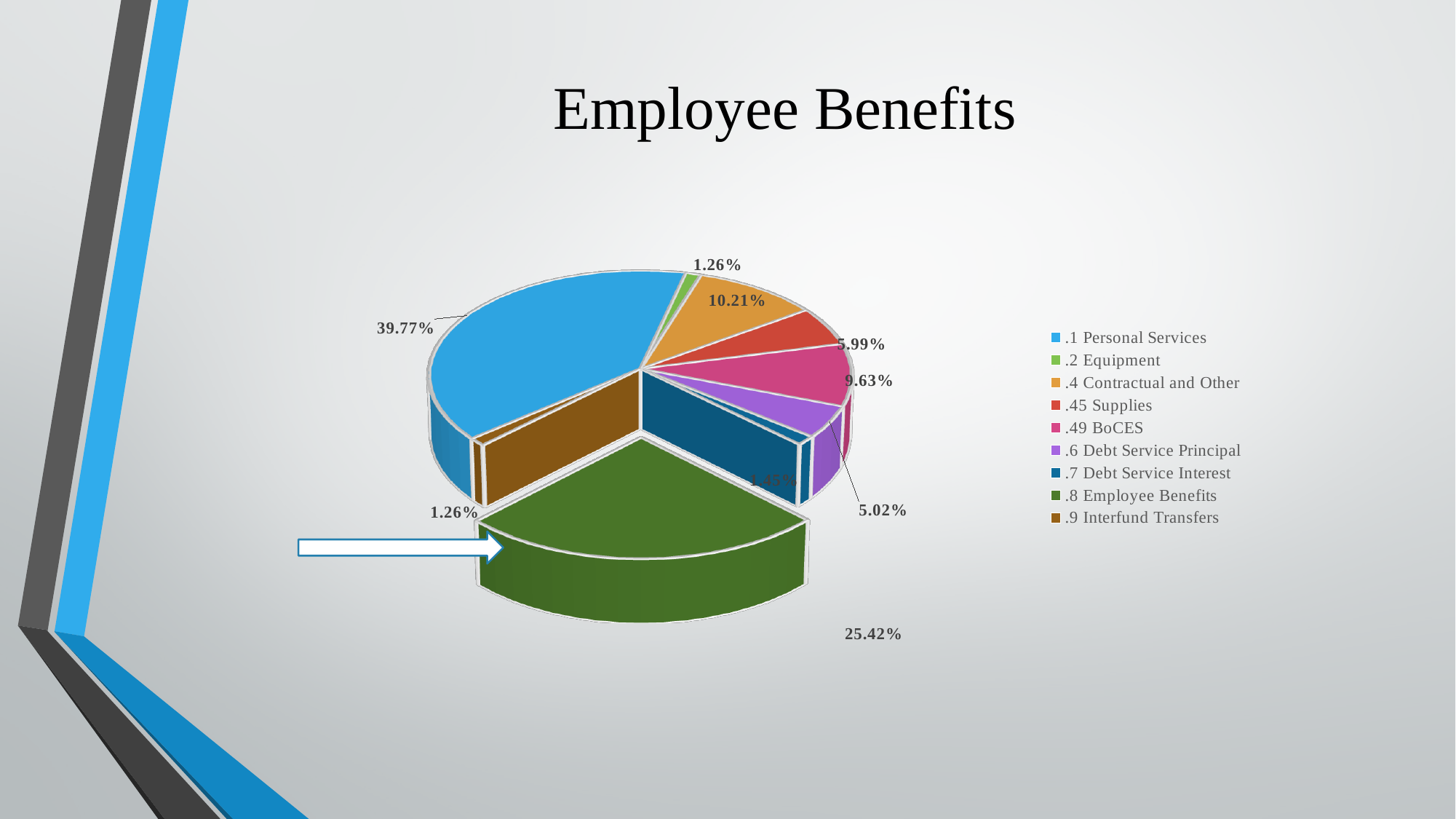
What share of the pie is labelled for .4 Contractual and Other? 10.21% What is the difference in percentage points between the .1 Personal Services slice and the .8 Employee Benefits slice? 14.35% What share of the pie is labelled for .6 Debt Service Principal? 5.02% What share of the pie is labelled for .1 Personal Services? 39.77% What share of the pie is labelled for .45 Supplies? 5.99% What share of the pie is labelled for .8 Employee Benefits? 25.42% Which slice is larger, .49 BoCES or .45 Supplies? .49 BoCES What is the title of the slide containing the pie chart? Employee Benefits Which category has the largest slice of the pie? .1 Personal Services What share of the pie is labelled for .49 BoCES? 9.63% How many categories does the legend of the pie chart list? 9 What kind of chart is shown on the slide? Pie chart